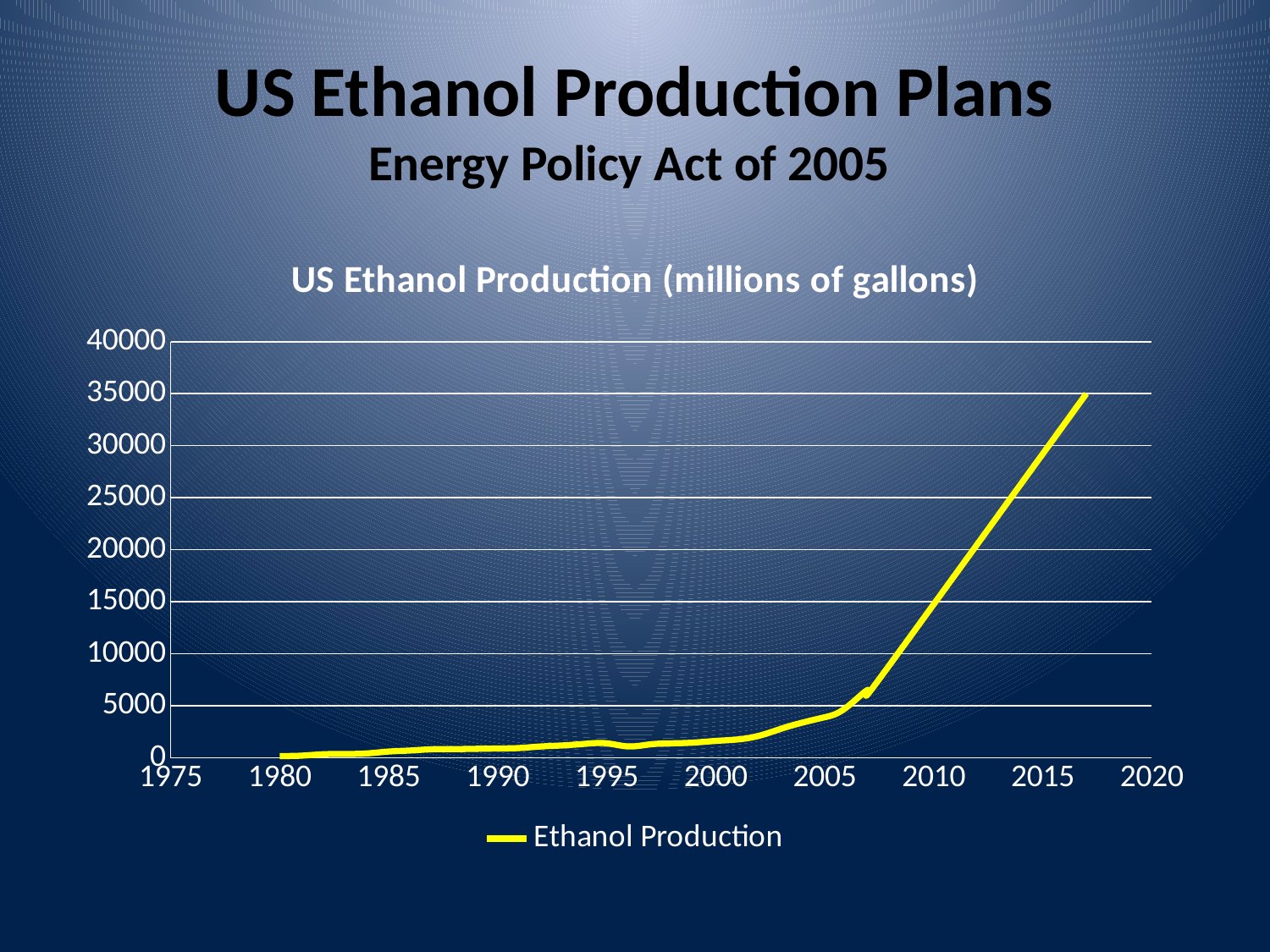
What is the title of the chart? US Ethanol Production (millions of gallons) Is the value for Ethanol Production in 2005 greater or less than 5000? less Do the values of Ethanol Production rise or fall from 1980 to the end of the line? rise What kind of chart is shown on the slide? line chart How many series does the legend list? 1 Is the value for Ethanol Production in 2000 greater or less than 5000? less Is the value for Ethanol Production in 1985 greater or less than 5000? less What is the name of the series shown in the legend? Ethanol Production